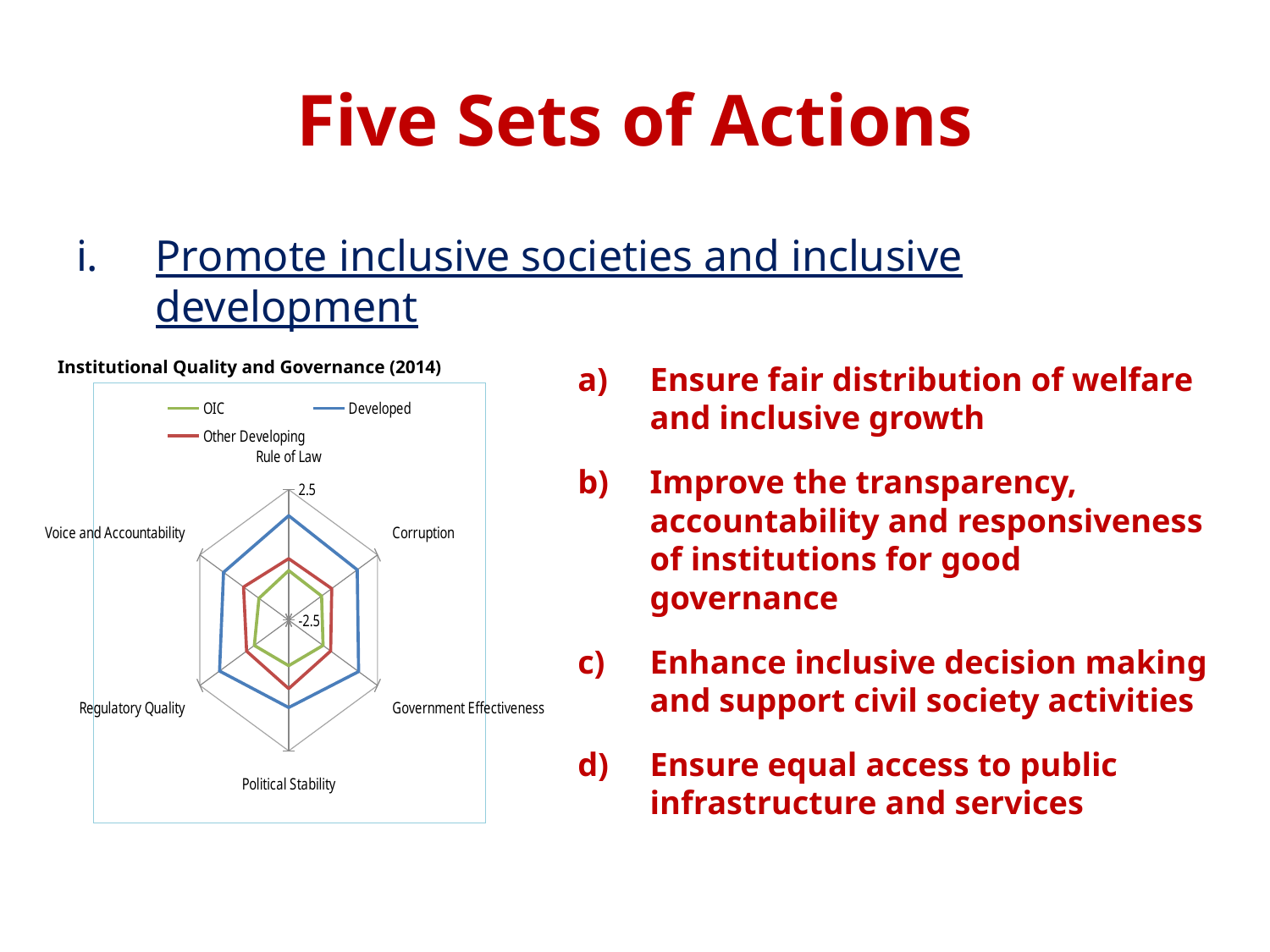
Which series has the lowest value on the Voice and Accountability axis? OIC How many governance dimensions (axes) does the radar chart plot? 6 How many series does the chart's legend list? 3 What kind of chart is shown on the slide? Radar chart Which series has the highest value on the Rule of Law axis? Developed On the Government Effectiveness axis, which series has the larger value, OIC or Developed? Developed On the Corruption axis, which series has the larger value, OIC or Other Developing? Other Developing Which series has the lowest value on the Political Stability axis? OIC Which series are listed in the chart's legend? OIC, Developed, Other Developing Is the value for Developed on the Rule of Law axis greater or less than 2.5? less What is the title of the chart? Institutional Quality and Governance (2014) Is the value for OIC on the Regulatory Quality axis greater or less than -2.5? greater